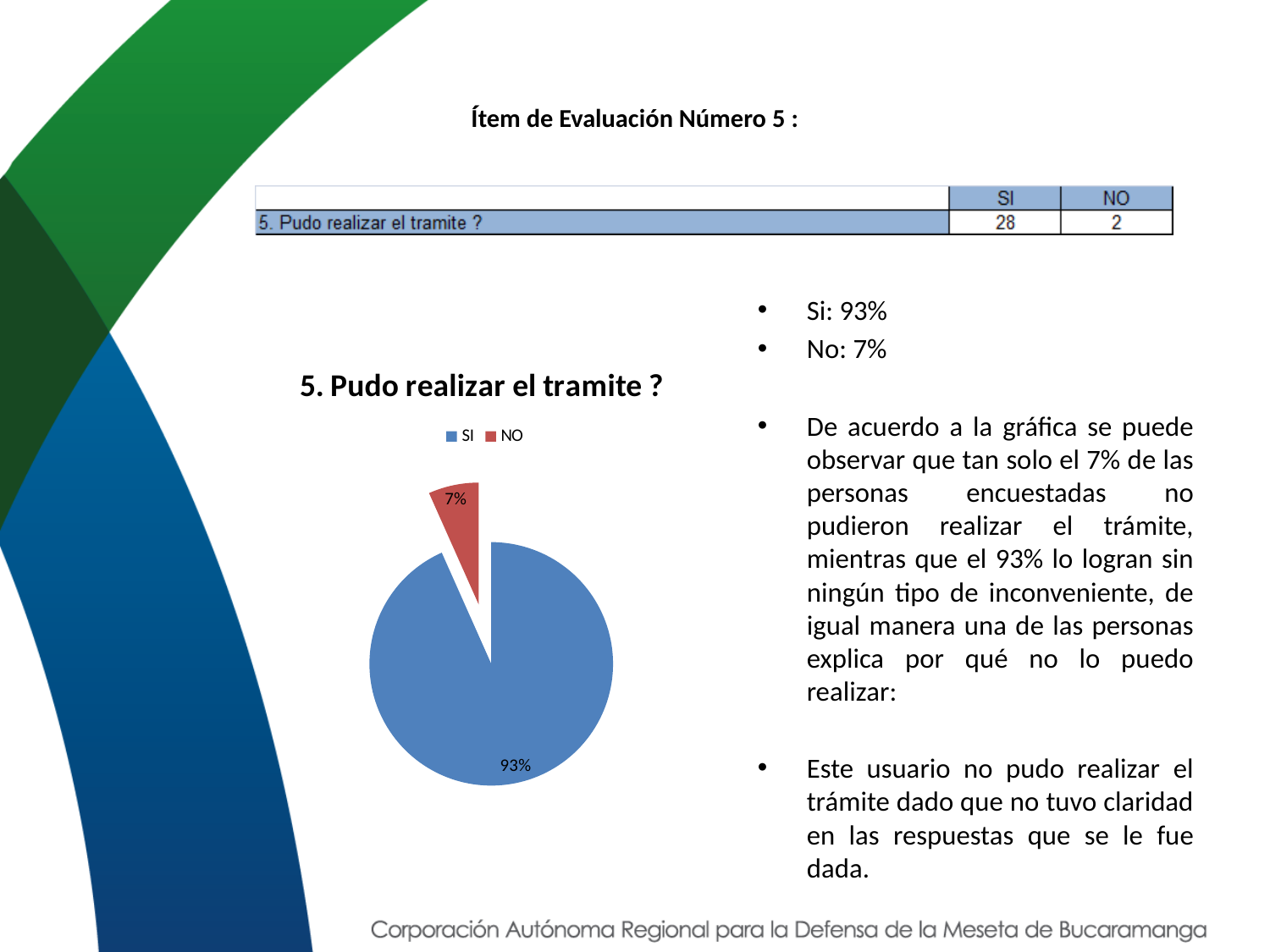
What kind of chart is shown on the slide? pie chart What is the difference in percentage points between the SI and NO slices of the pie chart? 86% What share of the pie chart does the NO slice represent? 7% What share of the pie chart does the SI slice represent? 93% Which slice of the pie chart is the largest? SI Is the share of the SI slice in the pie chart greater or less than 50%? greater How many slices does the pie chart have? 2 Which is larger in the pie chart, the SI slice or the NO slice? SI How many entries does the legend of the pie chart list? 2 Which slice of the pie chart is the smallest? NO What is the title of the pie chart? 5. Pudo realizar el tramite ? What colour is the NO slice in the pie chart? red